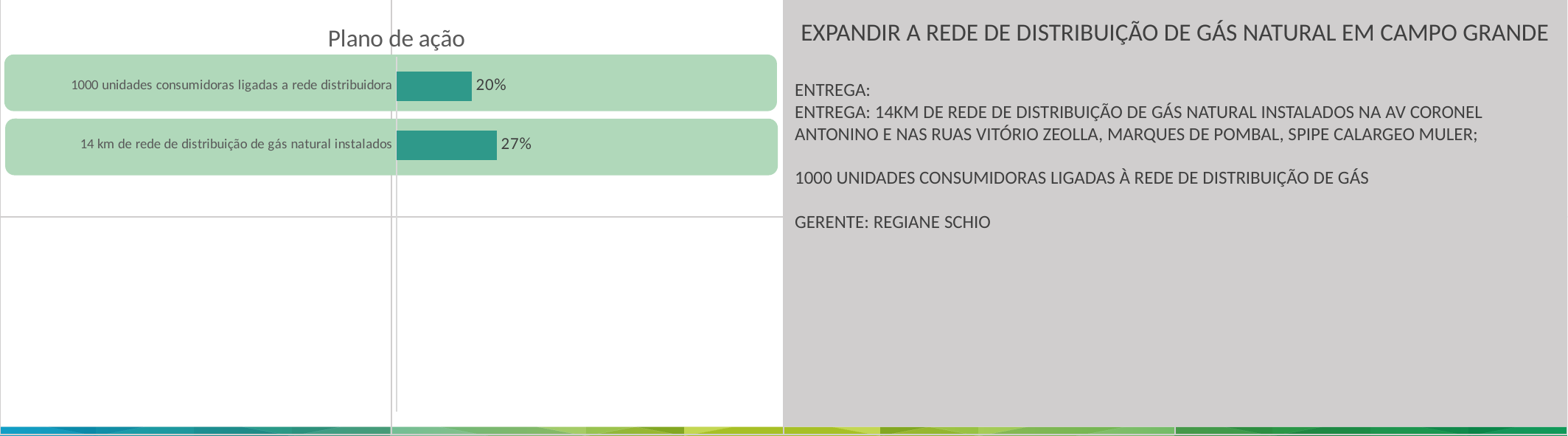
What is the value for "14 km de rede de distribuição de gás natural instalados"? 27% What colour are the bars in the chart? Teal green Which category has the lowest value? 1000 unidades consumidoras ligadas a rede distribuidora What is the value for "1000 unidades consumidoras ligadas a rede distribuidora"? 20% Which category has the highest value? 14 km de rede de distribuição de gás natural instalados What is the difference between the values for "14 km de rede de distribuição de gás natural instalados" and "1000 unidades consumidoras ligadas a rede distribuidora"? 7% How many categories are shown in the chart? 2 Which is larger: the value for "1000 unidades consumidoras ligadas a rede distribuidora" or for "14 km de rede de distribuição de gás natural instalados"? 14 km de rede de distribuição de gás natural instalados What kind of chart is shown on the slide? Bar chart What is the title of the chart? Plano de ação